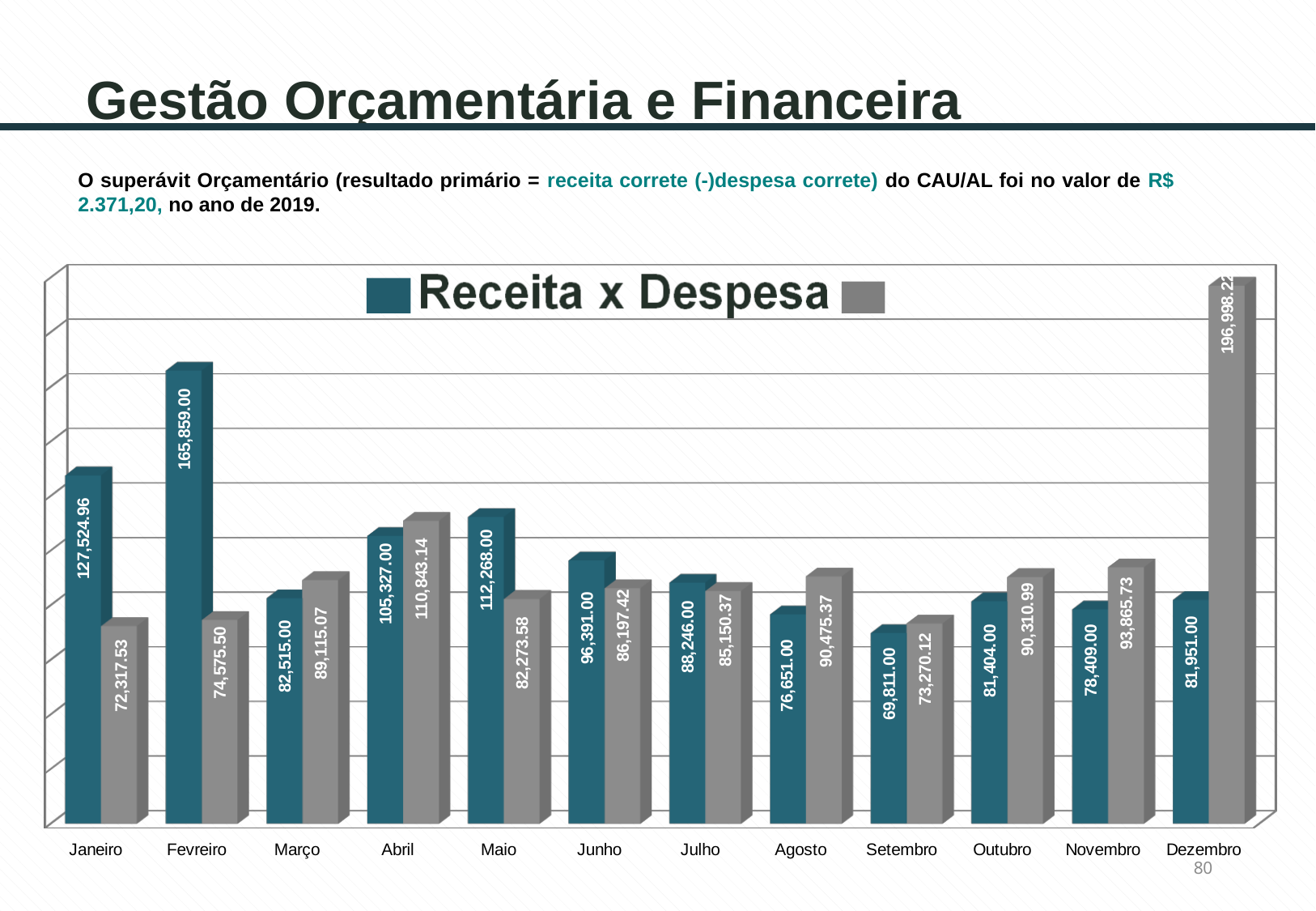
What is the difference between the dark teal (Receita) and gray (Despesa) bars for Janeiro? 55,207.43 For Março, which bar is larger: the dark teal (Receita) or the gray (Despesa)? Gray (Despesa) What is the value of the gray (Despesa) bar for Abril? 110,843.14 What type of chart is shown on the slide? Bar chart How many data series does the chart show? 2 How many months (categories) are shown on the x axis of the chart? 12 Which month has the highest gray (Despesa) bar? Dezembro What is the title of the chart? Receita x Despesa What is the value of the dark teal (Receita) bar for Fevreiro? 165,859.00 What is the value of the dark teal (Receita) bar for Setembro? 69,811.00 Which month has the highest dark teal (Receita) bar? Fevreiro Which month has the lowest gray (Despesa) bar? Janeiro